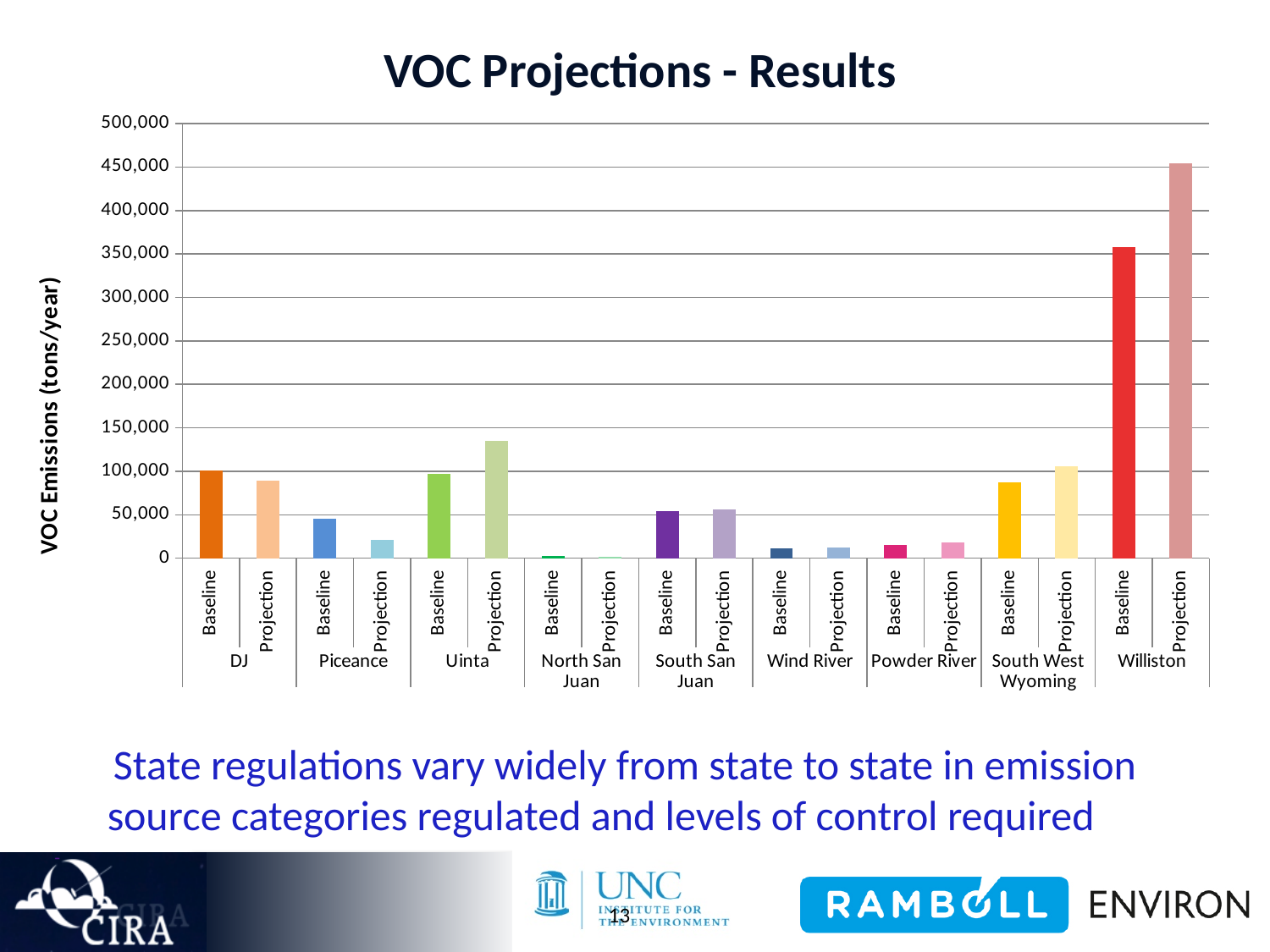
Is the Williston Projection value greater or less than 400,000? greater Which bar is the highest in the chart? Williston Projection How many bars are plotted in the chart in total? 18 Is the Piceance Projection value greater or less than 50,000? less Which basin has the lowest VOC emissions in the chart? North San Juan For DJ, which is larger, the Baseline or the Projection bar? Baseline What is the label on the vertical axis of the chart? VOC Emissions (tons/year) For Uinta, which is larger, the Baseline or the Projection bar? Projection What kind of chart is shown on the slide? Bar chart How many basins are shown along the x axis of the chart? 9 Is the Uinta Projection value greater or less than 100,000? greater